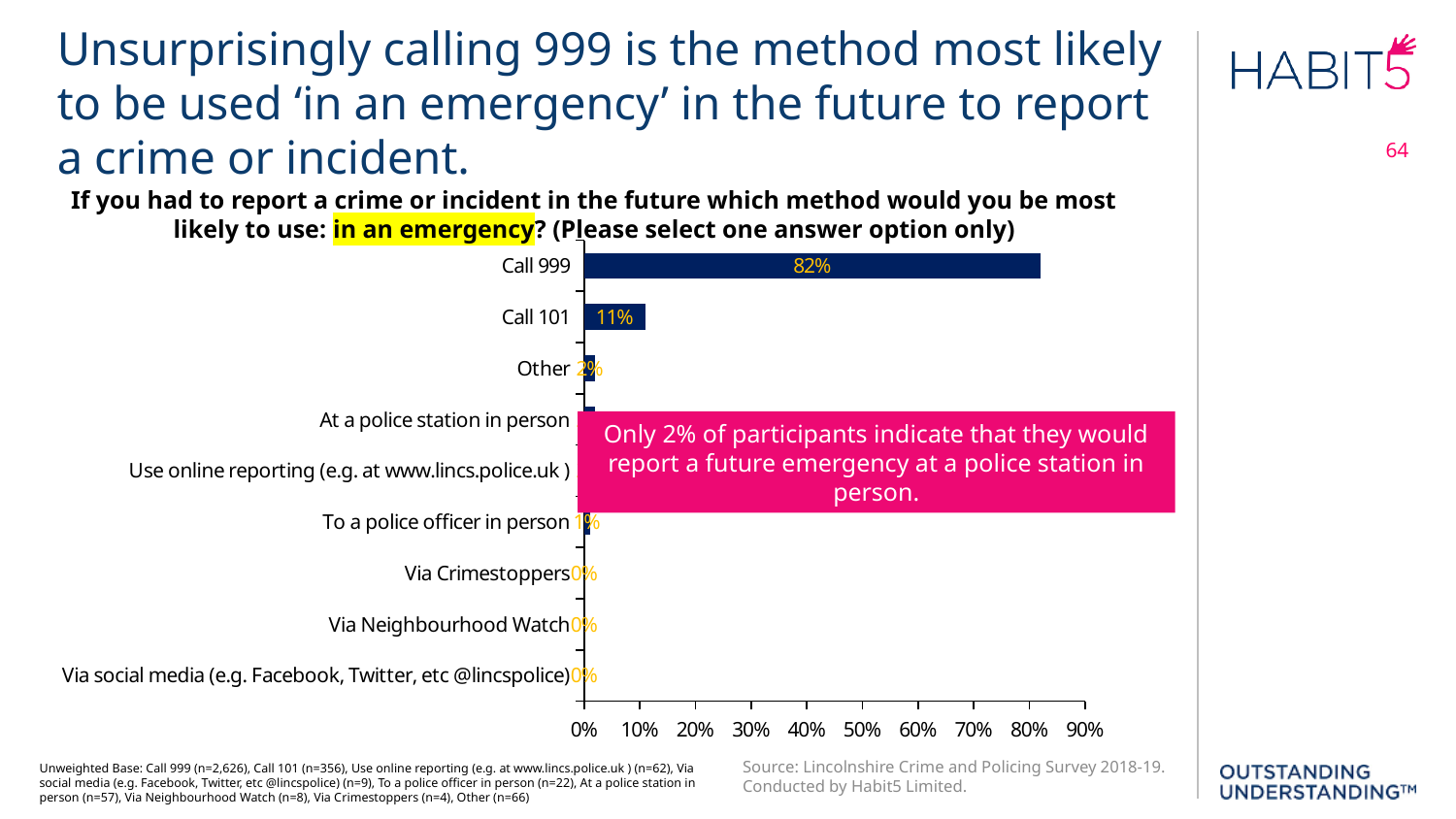
What value is shown for 'Other'? 2% What value is shown for 'To a police officer in person'? 1% What is the difference in percentage points between 'Call 999' and 'Call 101'? 71% What value is shown for 'Via Crimestoppers'? 0% Which is larger, the value for 'Call 101' or the value for 'Other'? Call 101 What percentage of participants said they would call 999 in an emergency? 82% What is the highest value shown on the x axis of the chart? 90% Which method has the highest percentage? Call 999 What kind of chart is shown on the slide? bar chart How many reporting methods are listed on the chart? 9 What is the value shown for 'Call 101'? 11% Is the value for 'Call 999' greater or less than 50%? greater